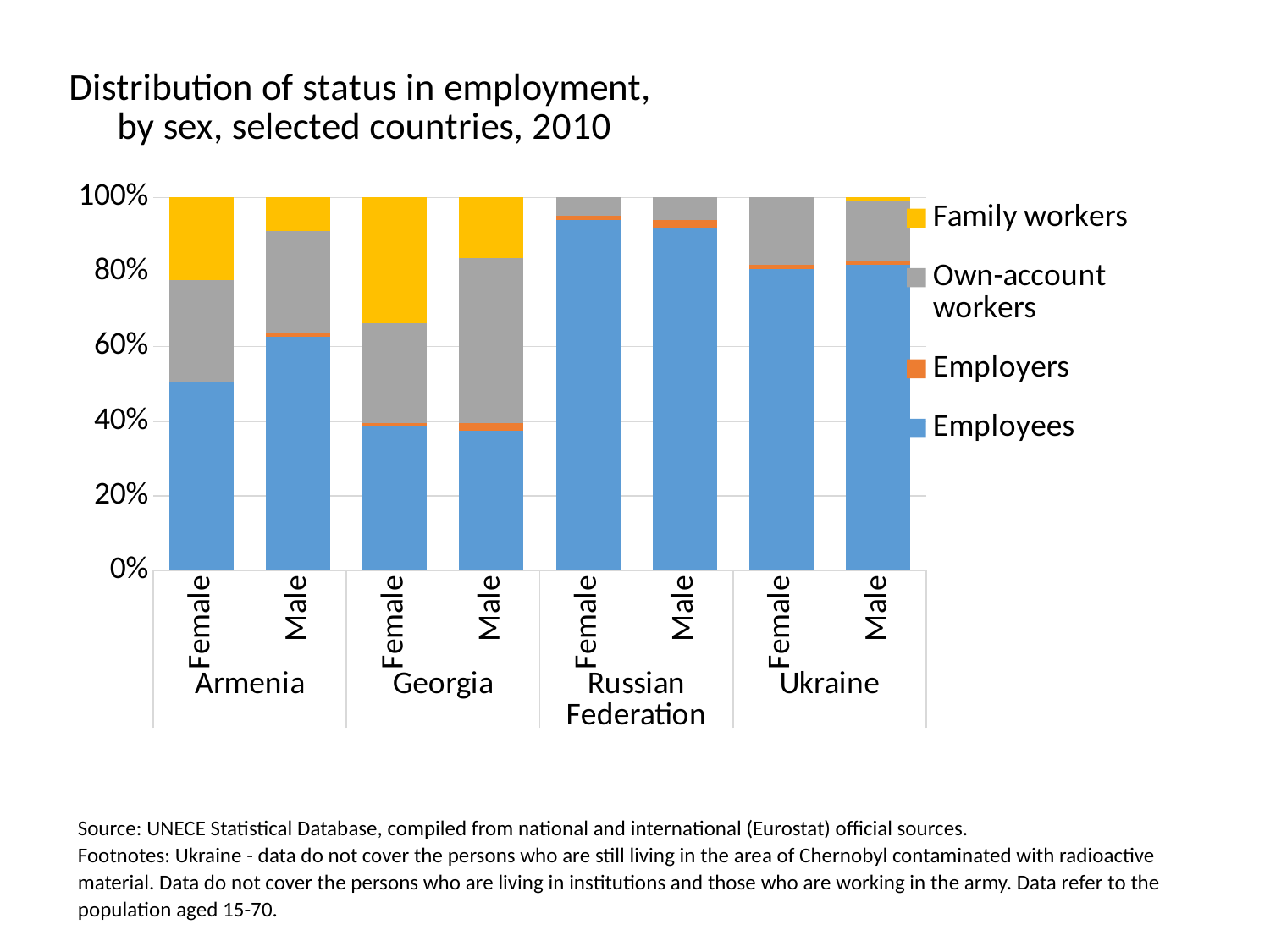
Which colour represents Family workers in the chart? Yellow Which country has the smallest Family workers share? Russian Federation How many series does the legend list? 4 How many bars are plotted in the chart? 8 How many countries are shown on the x axis? 4 Is the Employees share for Armenia Female greater or less than 60%? less What kind of chart is shown on the slide? Stacked bar chart Is the Employees share for Russian Federation Female greater or less than 80%? greater In Armenia, which has the larger Employees share, Female or Male? Male In Georgia, which has the larger Family workers share, Female or Male? Female Which country has the largest Family workers share among females? Georgia Is the Employees share for Ukraine Female greater or less than 60%? greater